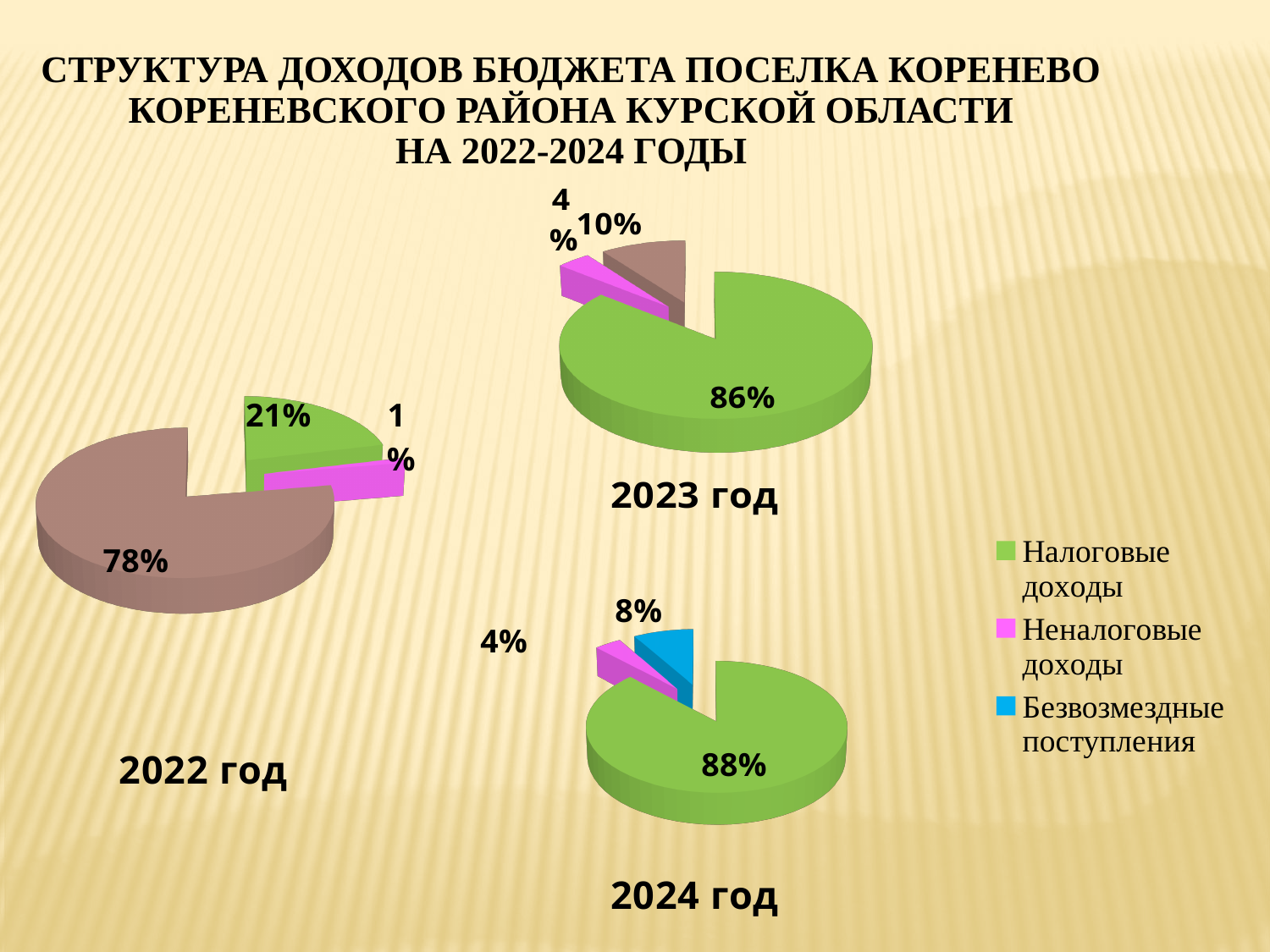
In the 2022 год chart, which category has the smallest slice? Неналоговые доходы What kind of chart is used for the 2022 год data? Pie chart In the 2024 год chart, what share is shown for Безвозмездные поступления? 8% In the 2023 год chart, what share is shown for Неналоговые доходы? 4% How many slices does the 2024 год pie chart have? 3 In the 2022 год chart, what is the percentage of the largest slice? 78% In the 2024 год chart, what share is shown for Налоговые доходы? 88% How many categories does the legend list? 3 In the 2022 год chart, what share is shown for Налоговые доходы? 21% By how many percentage points does the Налоговые доходы share in 2024 год exceed that in 2023 год? 2 In the 2023 год chart, what share is shown for Налоговые доходы? 86% Which year shows a larger share for Налоговые доходы, 2023 год or 2024 год? 2024 год